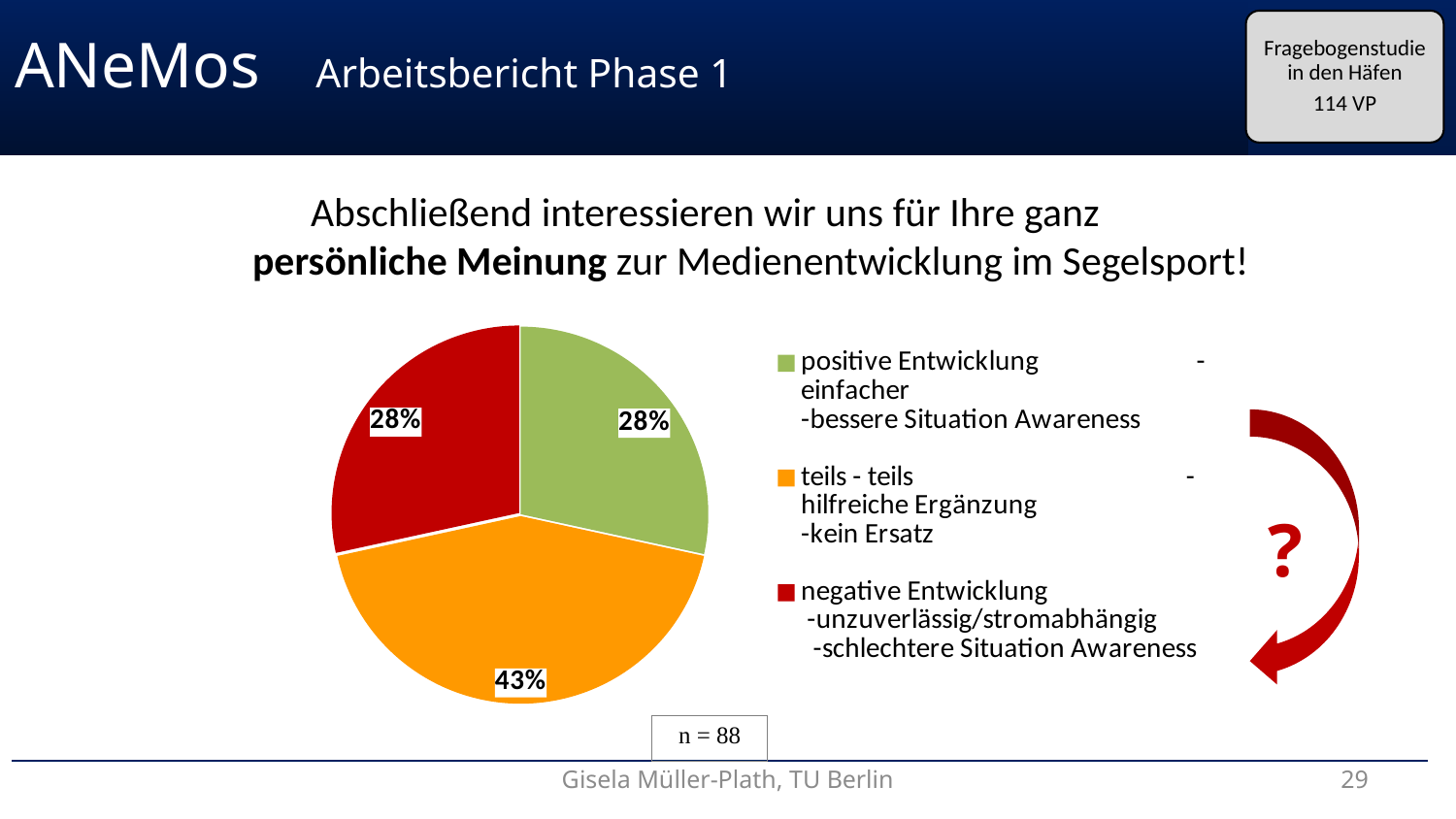
What colour is the "negative Entwicklung" slice? red What share of the pie does "negative Entwicklung" take? 28% Which is larger, the share for "teils - teils" or the share for "positive Entwicklung"? teils - teils What is the difference in percentage points between the "teils - teils" slice and the "negative Entwicklung" slice? 15 What kind of chart is shown on the slide? pie chart Which category has the largest slice of the pie? teils - teils Is the share for "teils - teils" greater or less than 40%? greater How many slices does the pie chart have? 3 How many entries does the legend list? 3 What sample size (n) is shown below the pie chart? n = 88 What share of the pie does "teils - teils" take? 43% What share of the pie does "positive Entwicklung" take? 28%